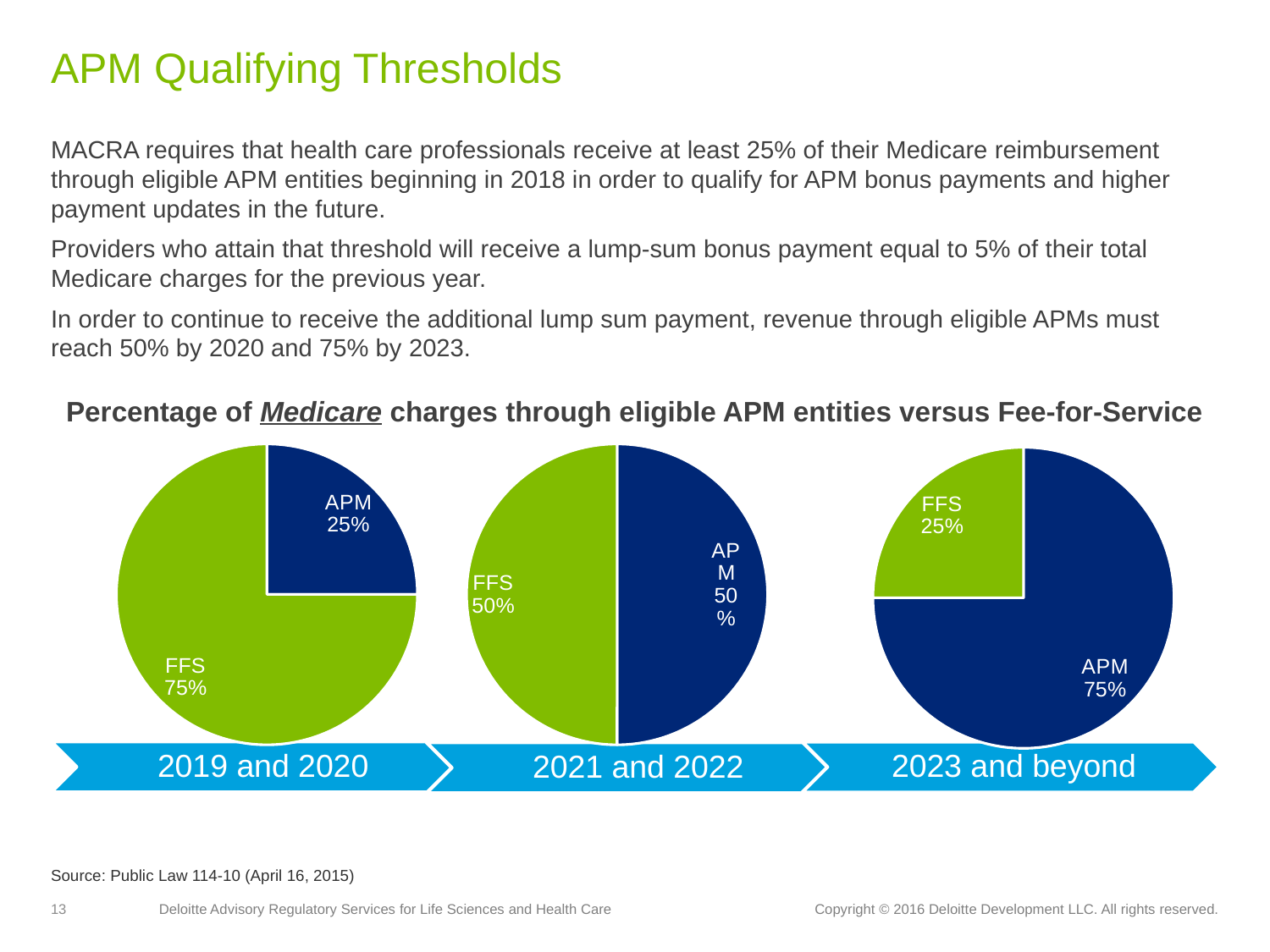
In the 2019 and 2020 pie chart, what percentage is shown for APM? 25% What kind of chart is used on this slide? Pie chart How many slices does the 2021 and 2022 pie chart have? 2 Across the three pie charts from 2019 and 2020 to 2023 and beyond, does the APM share rise or fall? Rise In the 2021 and 2022 pie chart, what percentage is shown for FFS? 50% In the 2023 and beyond pie chart, what percentage is shown for FFS? 25% In the 2019 and 2020 pie chart, which slice is larger, APM or FFS? FFS In the 2019 and 2020 pie chart, what is the difference between the FFS and APM percentages? 50% In the 2019 and 2020 pie chart, what percentage is shown for FFS? 75% How many pie charts are shown on the slide? 3 In the 2023 and beyond pie chart, which slice is the largest? APM In the 2023 and beyond pie chart, what percentage is shown for APM? 75%